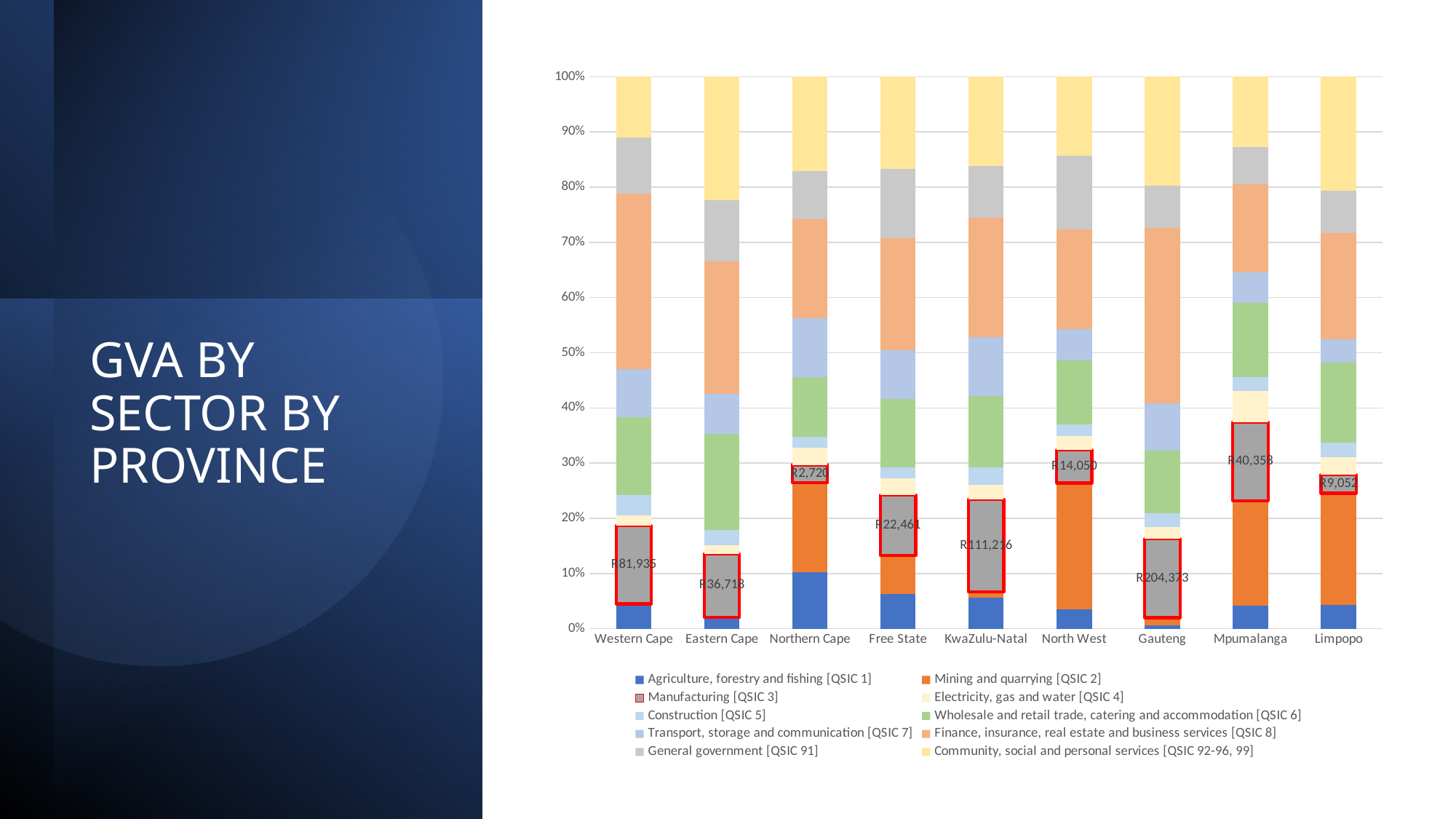
How many provinces are shown along the x axis of the chart? 9 What is the Manufacturing [QSIC 3] value labelled for KwaZulu-Natal? R111,216 What is the Manufacturing [QSIC 3] value labelled for Northern Cape? R2,720 What is the Manufacturing [QSIC 3] value labelled for Gauteng? R204,373 Which has the larger labelled Manufacturing value, Western Cape or Eastern Cape? Western Cape Which province has the lowest labelled Manufacturing [QSIC 3] value? Northern Cape How many sectors does the chart legend list? 10 What type of chart is shown on the slide? Stacked bar chart What is the difference between the labelled Manufacturing values for Gauteng and KwaZulu-Natal? R93,157 Which province has the highest labelled Manufacturing [QSIC 3] value? Gauteng What is the title of the slide containing the chart? GVA BY SECTOR BY PROVINCE What is the Manufacturing [QSIC 3] value labelled for Mpumalanga? R40,358